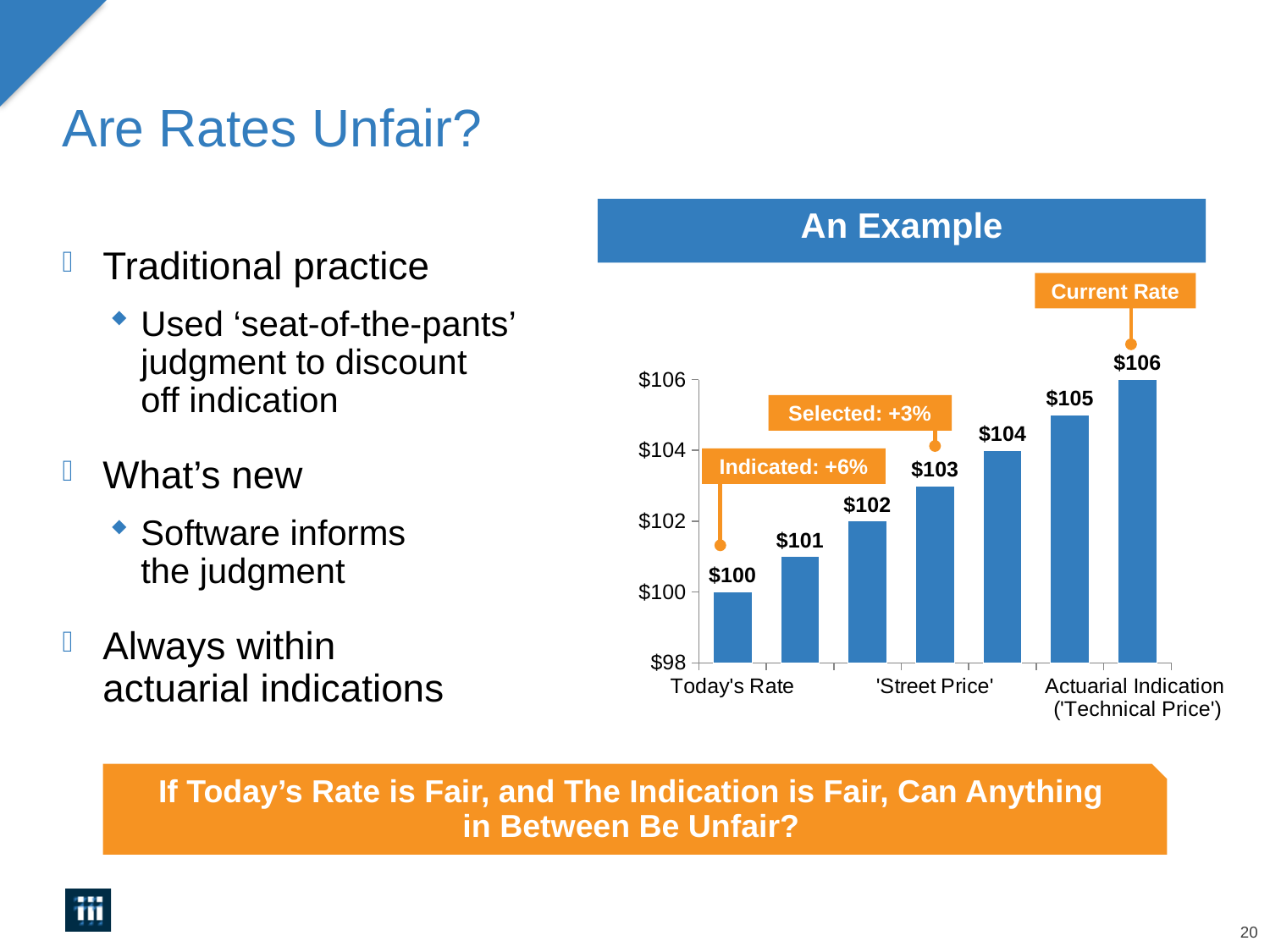
What is the title of the chart? An Example What is the difference between the Actuarial Indication ('Technical Price') and Today's Rate? $6 Which is larger, 'Street Price' or Today's Rate? 'Street Price' Do the values rise or fall from left to right along the x axis? Rise What is the value for 'Street Price'? $103 What kind of chart is shown? Bar chart What is the value for Actuarial Indication ('Technical Price')? $106 What is the value for Today's Rate? $100 How many bars are plotted in the chart? 7 What is the difference between 'Street Price' and Today's Rate? $3 Which category has the lowest value? Today's Rate Which category has the highest value? Actuarial Indication ('Technical Price')